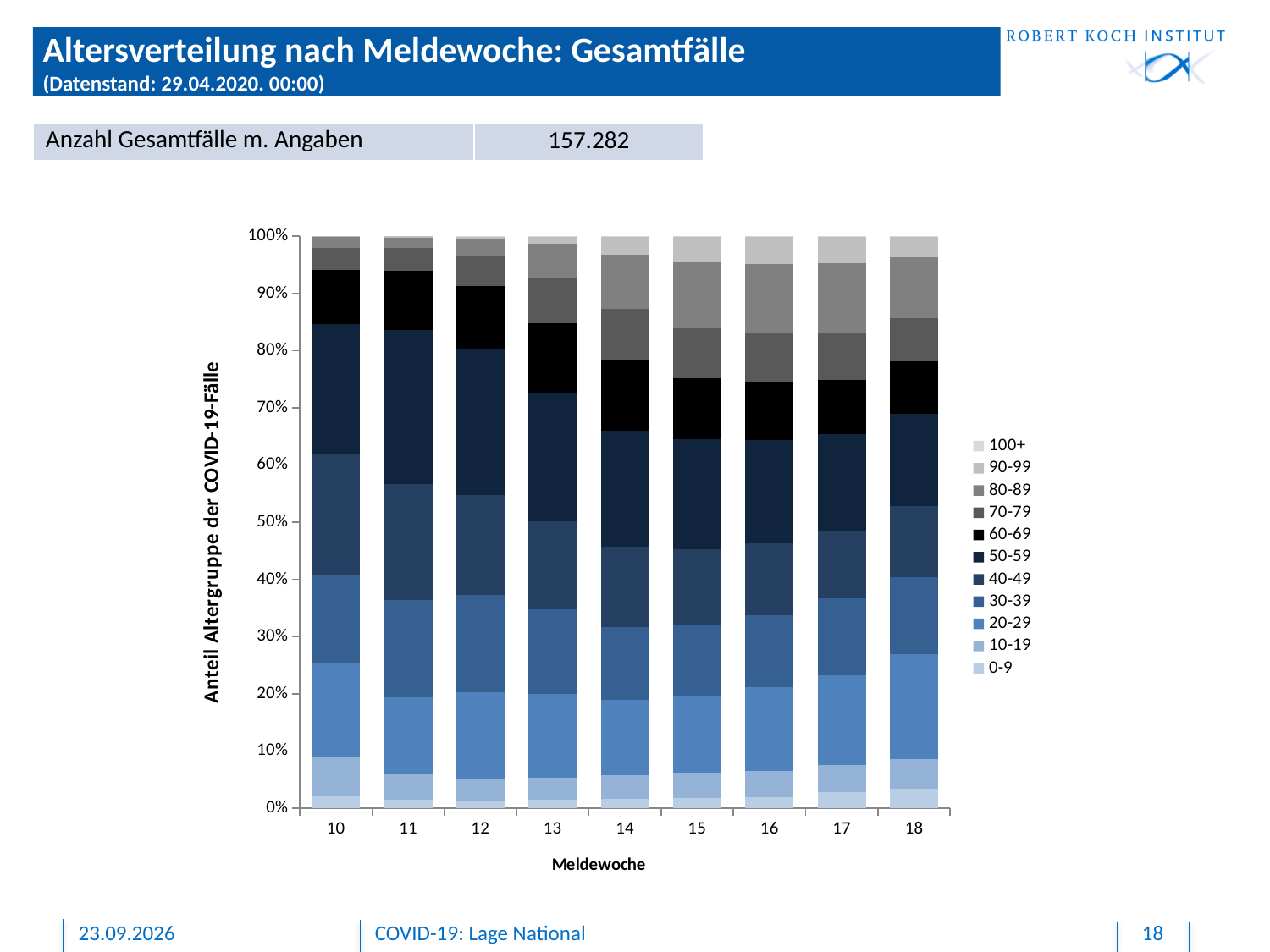
What is the title of the chart slide? Altersverteilung nach Meldewoche: Gesamtfälle Which week is the first category on the x axis of the chart? 10 In week 10, is the combined share of all age groups up to 50-59 greater or less than 80%? greater In week 18, is the combined share of all age groups up to 50-59 greater or less than 80%? less In week 18, is the combined share of the age groups 0-9, 10-19 and 20-29 greater or less than 20%? greater What is the label of the y axis of the chart? Anteil Altergruppe der COVID-19-Fälle How many reporting weeks (Meldewochen) are shown on the x axis of the chart? 9 Does the share of the 40-49 age group rise or fall from week 10 to week 18? Fall What kind of chart is shown on the slide? Stacked bar chart How many age groups does the chart legend list? 11 Does the share of the 80-89 age group rise or fall from week 10 to week 18? Rise In week 10, which age group has the larger share: 40-49 or 80-89? 40-49